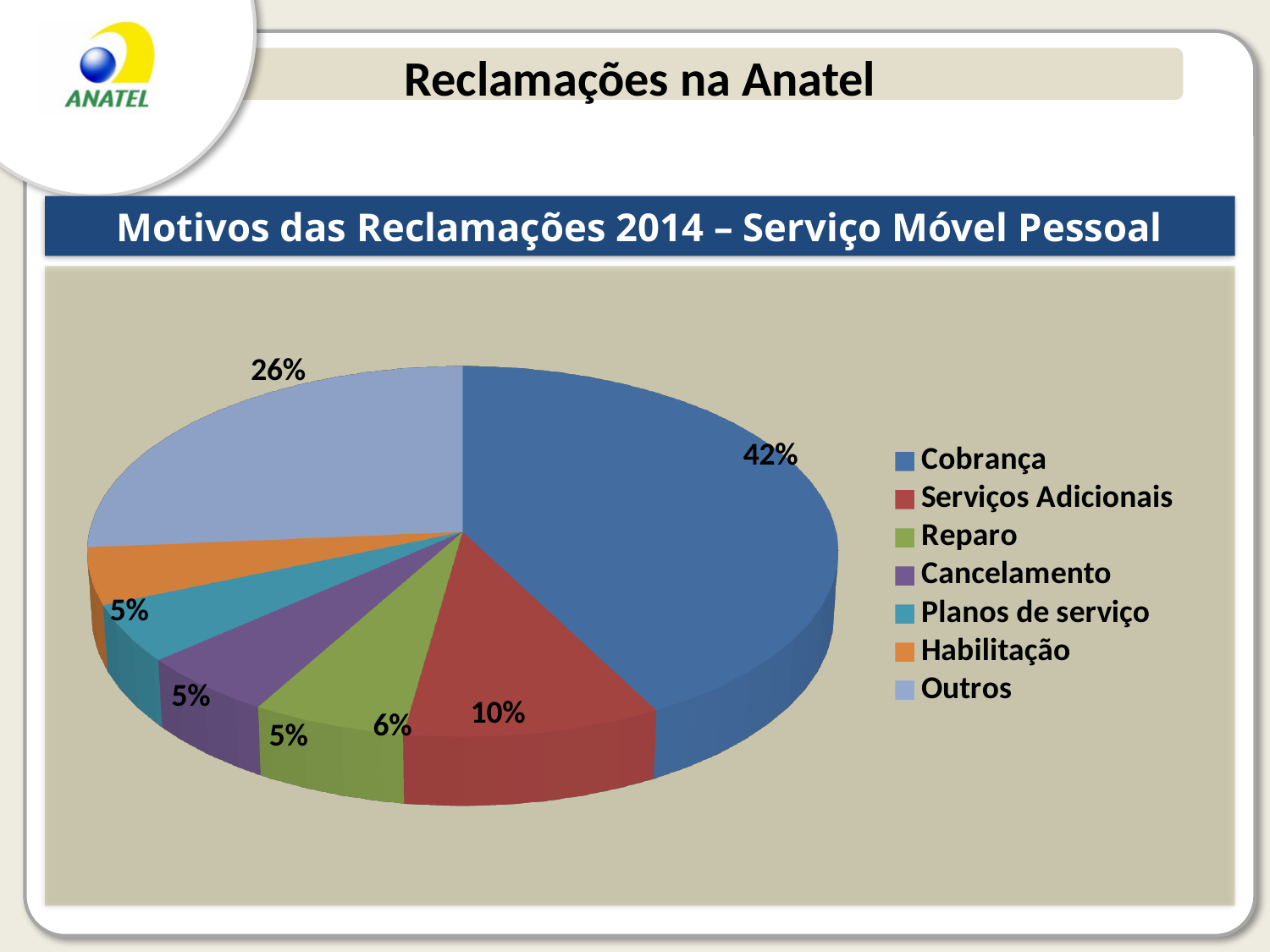
What percentage of the pie corresponds to Outros? 26% What colour represents Cancelamento in the chart? Purple Which category has the largest share of complaints? Cobrança Which is larger, the share for Serviços Adicionais or the share for Reparo? Serviços Adicionais What share of complaints is attributed to Cobrança? 42% What percentage is shown for Reparo? 6% What is the difference in percentage points between Cobrança and Outros? 16 What is the share for Serviços Adicionais? 10% What is the title of the chart? Motivos das Reclamações 2014 – Serviço Móvel Pessoal What kind of chart is shown on the slide? Pie chart What share does Habilitação represent? 5% How many categories does the legend list? 7